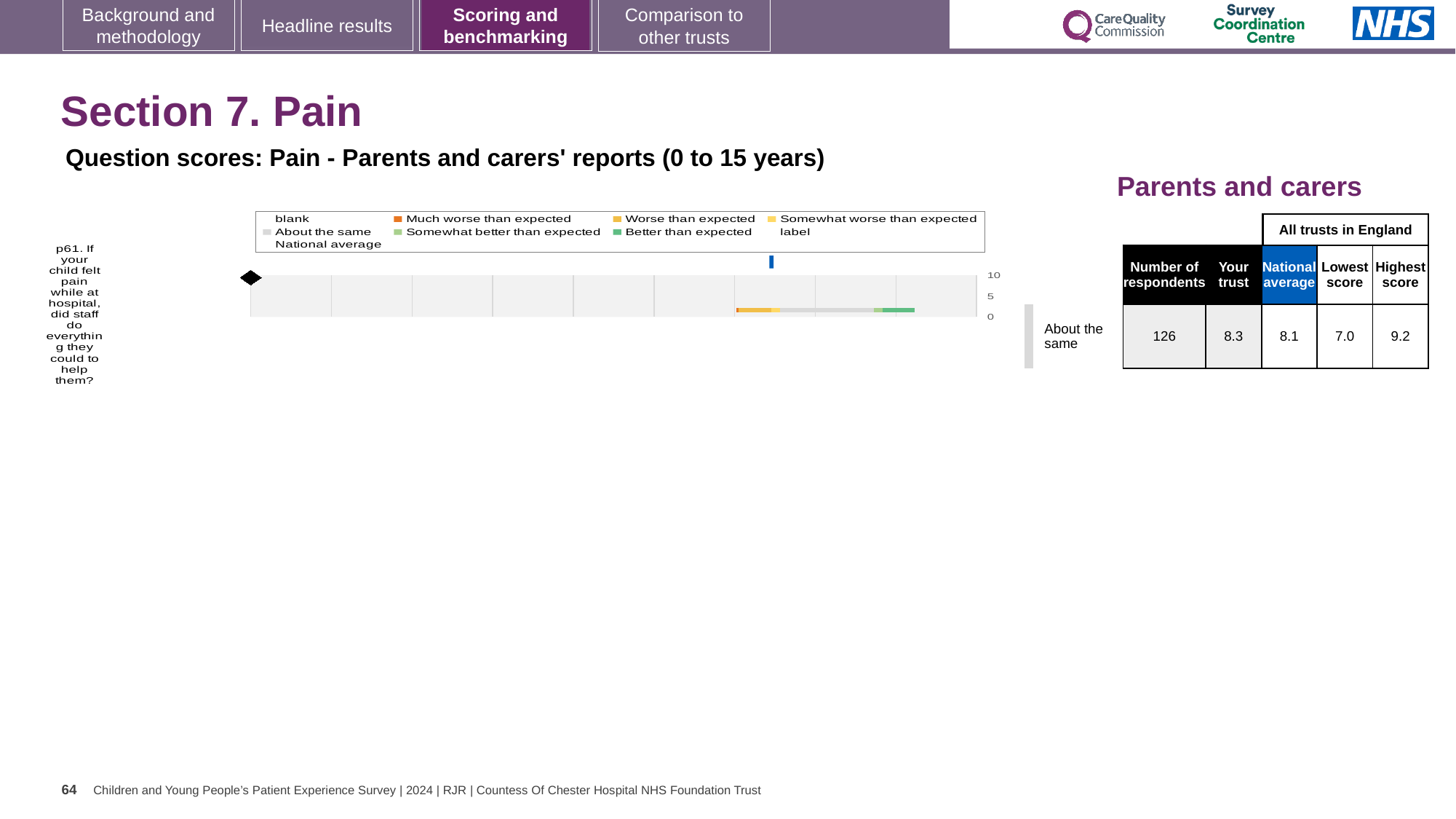
What kind of chart is shown on the slide? bar chart According to the table, how many respondents answered the question? 126 According to the table, what is the score for Your trust for the 'About the same' row? 8.3 According to the table, what is the Lowest score among all trusts in England? 7.0 What is the difference between the Highest score and the Lowest score in the table? 2.2 According to the table, what is the National average score? 8.1 Which is larger, the Your trust score or the National average score? Your trust According to the table, what is the Highest score among all trusts in England? 9.2 How many questions (categories) are plotted in the chart? 1 Which legend entry is shown in dark green? Better than expected What is the difference between the Your trust score and the National average score? 0.2 What is the highest value shown on the chart's axis? 10